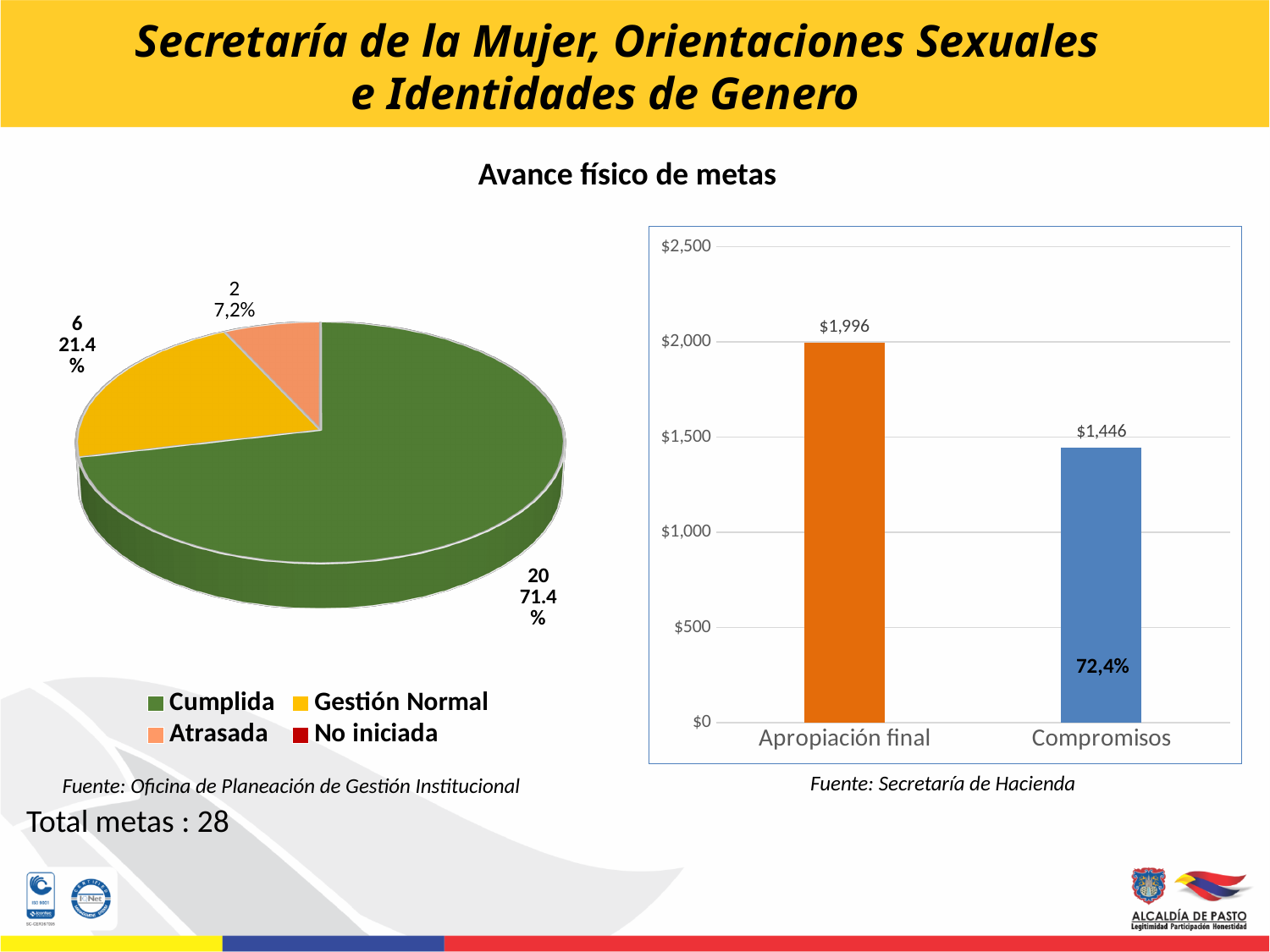
In the pie chart on the left, what percentage share does the Gestión Normal slice have? 21.4% In the pie chart on the left, which category has the largest slice? Cumplida In the pie chart on the left, what is the difference between the number of Cumplida metas and the number of Gestión Normal metas? 14 In the bar chart on the right, what is the difference between Apropiación final and Compromisos? $550 In the bar chart on the right, what percentage is printed on the Compromisos bar? 72,4% In the pie chart on the left, how many entries does the legend list? 4 In the pie chart on the left, how many metas are labelled Cumplida? 20 In the pie chart on the left, what percentage share does the Cumplida slice have? 71.4% In the bar chart on the right, what is the value for Apropiación final? $1,996 In the bar chart on the right, what is the value for Compromisos? $1,446 What kind of chart is the chart on the right of the slide? Bar chart In the pie chart on the left, how many metas are labelled Atrasada? 2